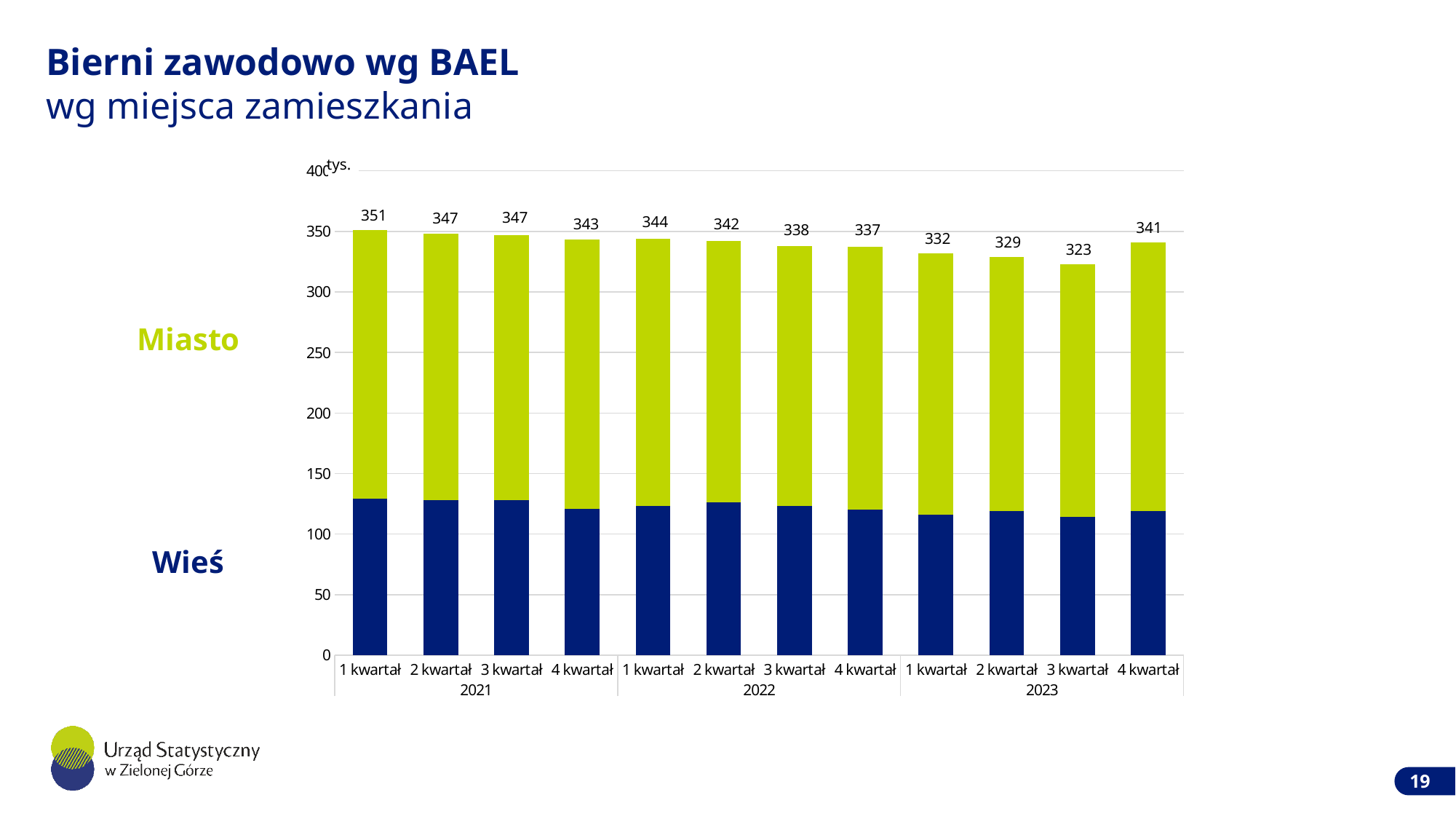
What is the total value for 3 kwartał 2023? 323 How many series does the chart show? 2 Which quarter has the highest total? 1 kwartał 2021 What is the total value for 1 kwartał 2021? 351 Do the totals rise or fall from 1 kwartał 2023 to 3 kwartał 2023? fall How many quarterly bars are shown in the chart? 12 What is the difference between the total for 1 kwartał 2021 and the total for 3 kwartał 2023? 28 Is the value for Wieś in 1 kwartał 2021 greater or less than 100? greater What kind of chart is shown on the slide? stacked bar chart Which quarter has the lowest total? 3 kwartał 2023 What is the total value for 4 kwartał 2022? 337 Which is larger, the total for 3 kwartał 2023 or the total for 4 kwartał 2023? 4 kwartał 2023